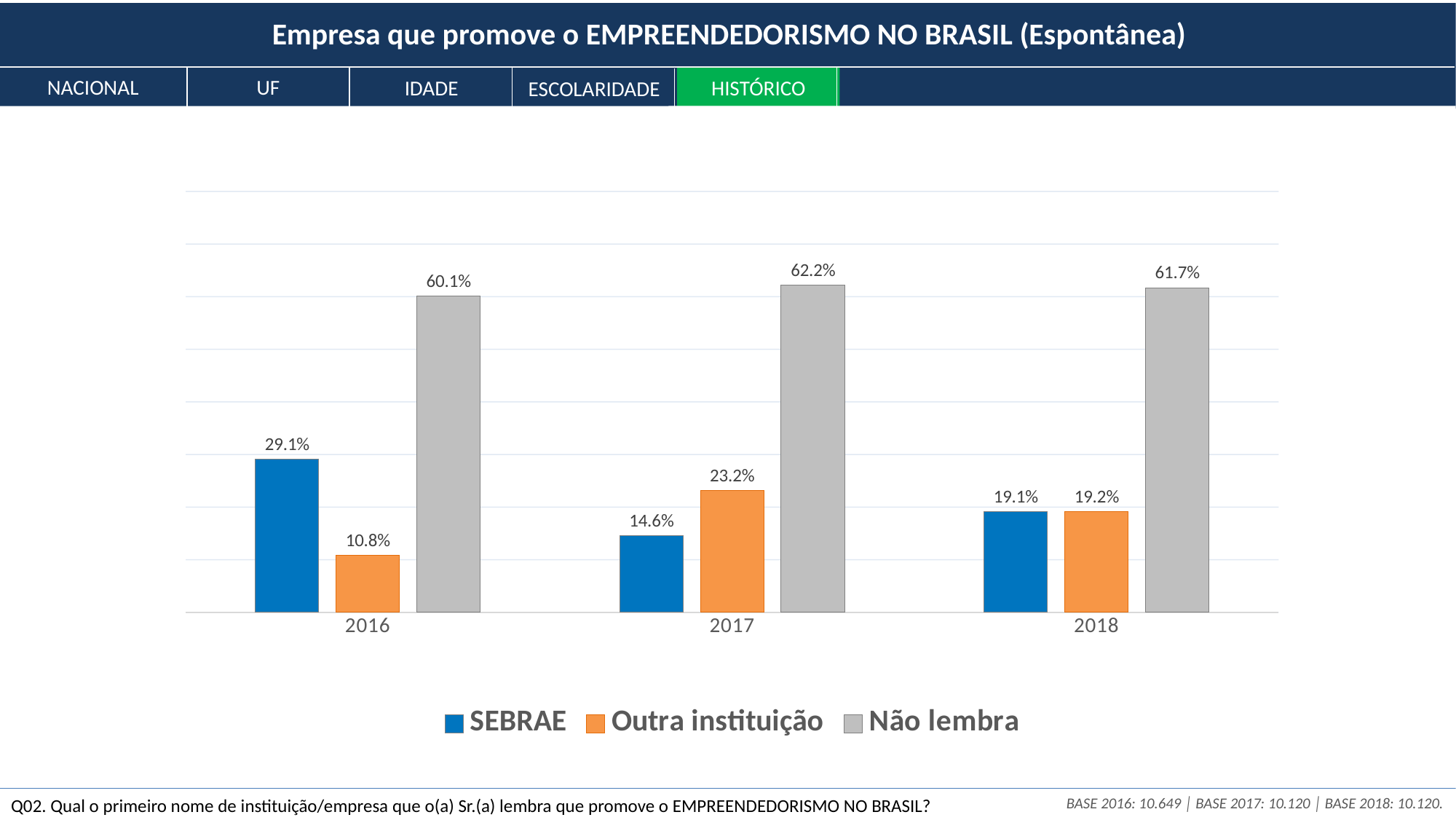
What kind of chart is shown on the slide? Bar chart In which year was the Outra instituição value lowest? 2016 What was the value for Outra instituição in 2017? 23.2% Did the SEBRAE values rise or fall from 2016 to 2018? Fall Which colour represents Não lembra in the legend? Grey In which year was the SEBRAE value highest? 2016 What was the value for SEBRAE in 2016? 29.1% What was the value for Não lembra in 2018? 61.7% Which was larger in 2017, SEBRAE or Outra instituição? Outra instituição How many series does the legend list? 3 How many years are shown on the x axis? 3 What is the difference between the SEBRAE values in 2016 and 2017? 14.5%